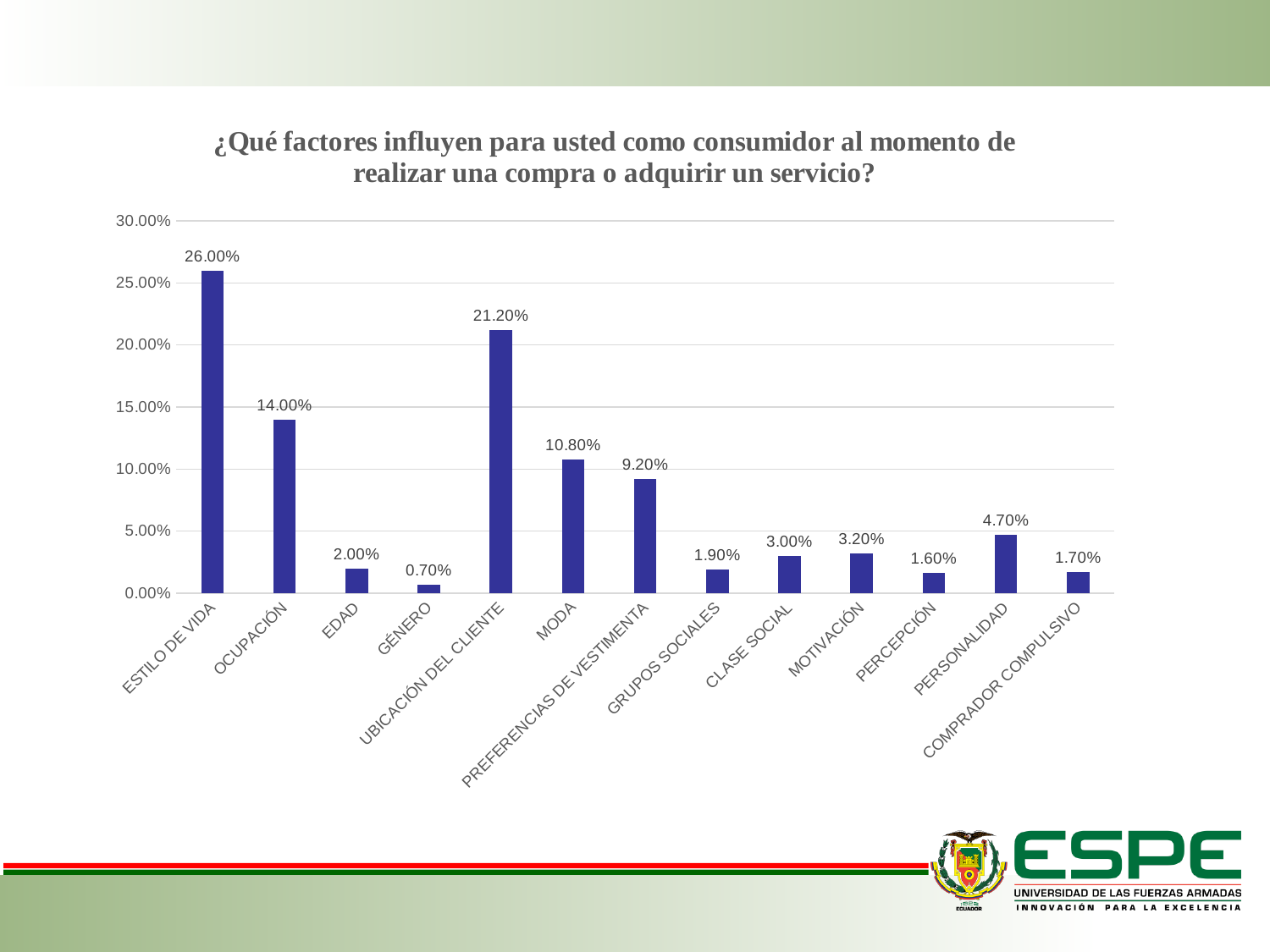
How many categories are shown on the x axis? 13 What kind of chart is shown on the slide? Bar chart Is the value for OCUPACIÓN greater or less than 10.00%? greater What is the value for ESTILO DE VIDA? 26.00% Which is larger, the value for MODA or the value for PREFERENCIAS DE VESTIMENTA? MODA What is the value for PERSONALIDAD? 4.70% Which category has the highest value? ESTILO DE VIDA What is the difference between the values for ESTILO DE VIDA and OCUPACIÓN? 12.00% What is the value for UBICACIÓN DEL CLIENTE? 21.20% What is the difference between the values for MOTIVACIÓN and PERCEPCIÓN? 1.60% What is the title of the chart? ¿Qué factores influyen para usted como consumidor al momento de realizar una compra o adquirir un servicio? Which category has the lowest value? GÉNERO